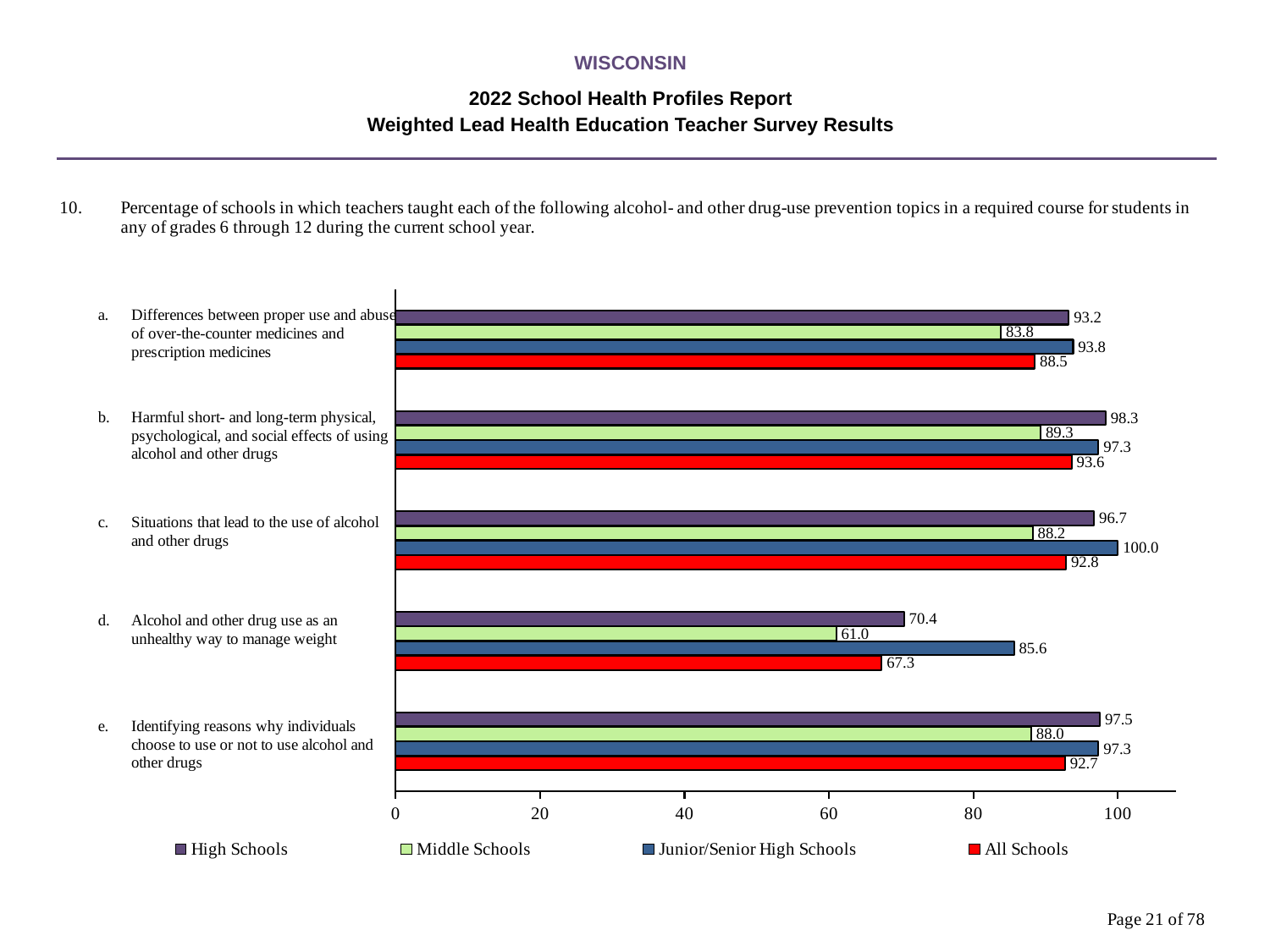
For topic b, which is larger: the High Schools value or the Middle Schools value? High Schools What is the difference between the Junior/Senior High Schools value and the Middle Schools value for topic d? 24.6 What is the value for Junior/Senior High Schools for topic c (situations that lead to the use of alcohol and other drugs)? 100.0 How many topics (categories) are shown on the chart? 5 Which topic has the lowest value for All Schools? d. Alcohol and other drug use as an unhealthy way to manage weight Which topic has the highest value for High Schools? b. Harmful short- and long-term physical, psychological, and social effects of using alcohol and other drugs What is the value for All Schools for topic e (identifying reasons why individuals choose to use or not to use alcohol and other drugs)? 92.7 Which colour represents All Schools in the legend? Red How many series does the legend list? 4 What kind of chart is shown on the slide? Bar chart What is the value for Middle Schools for topic d (alcohol and other drug use as an unhealthy way to manage weight)? 61.0 What is the value for High Schools for topic a (differences between proper use and abuse of over-the-counter medicines and prescription medicines)? 93.2